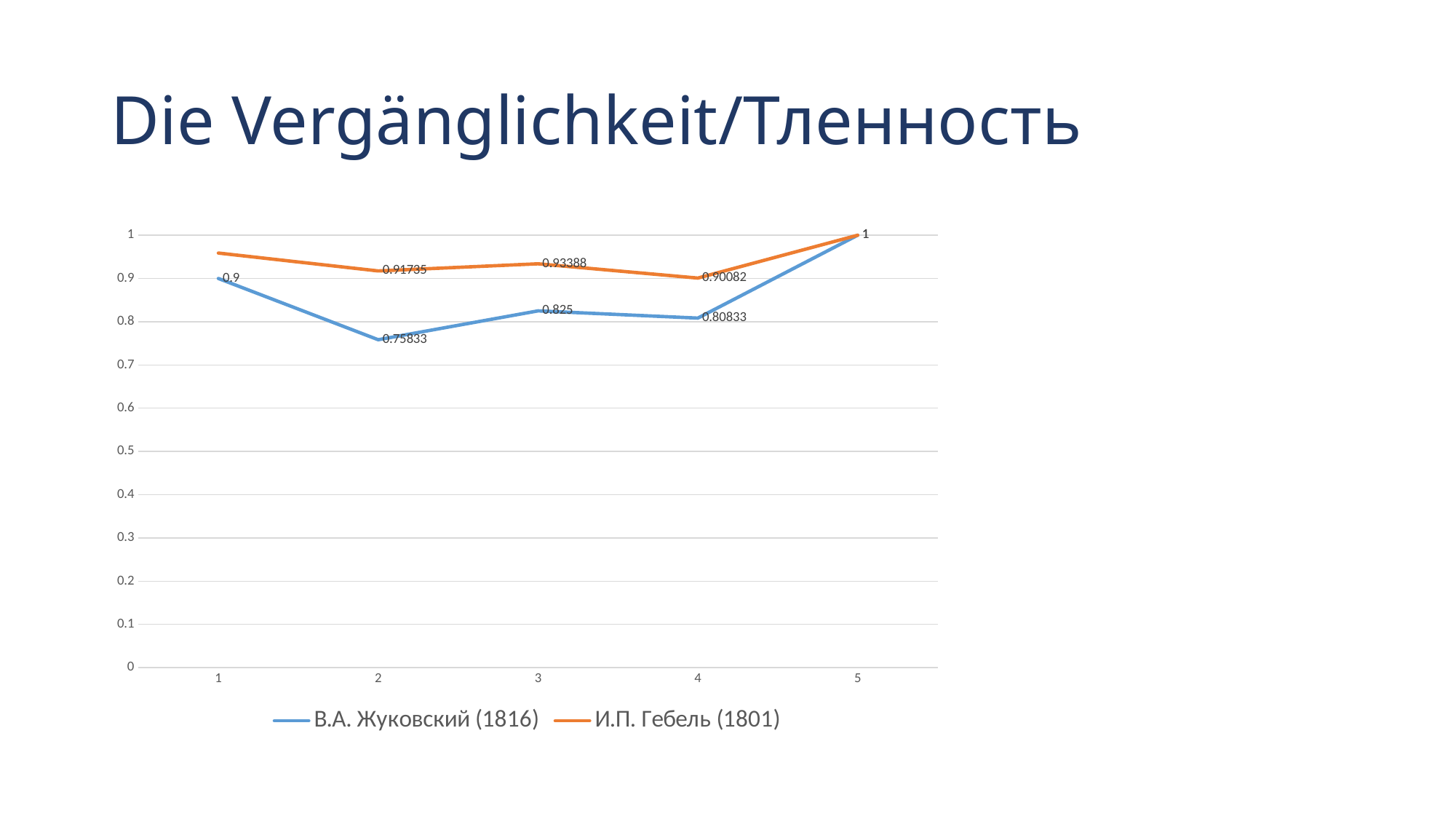
What kind of chart is shown on the slide? line chart What is the value for И.П. Гебель (1801) at point 3? 0.93388 What is the value for И.П. Гебель (1801) at point 4? 0.90082 Which colour is used for the И.П. Гебель (1801) line? orange How many series does the legend list? 2 Is the value for И.П. Гебель (1801) at point 1 greater or less than 0.9? greater At which point does В.А. Жуковский (1816) reach its highest value? 5 What is the value for В.А. Жуковский (1816) at point 2? 0.75833 How many points are plotted along the x axis for each series? 5 Which series has the larger value at point 2, В.А. Жуковский (1816) or И.П. Гебель (1801)? И.П. Гебель (1801) What is the value for В.А. Жуковский (1816) at point 3? 0.825 At which point does В.А. Жуковский (1816) reach its lowest value? 2